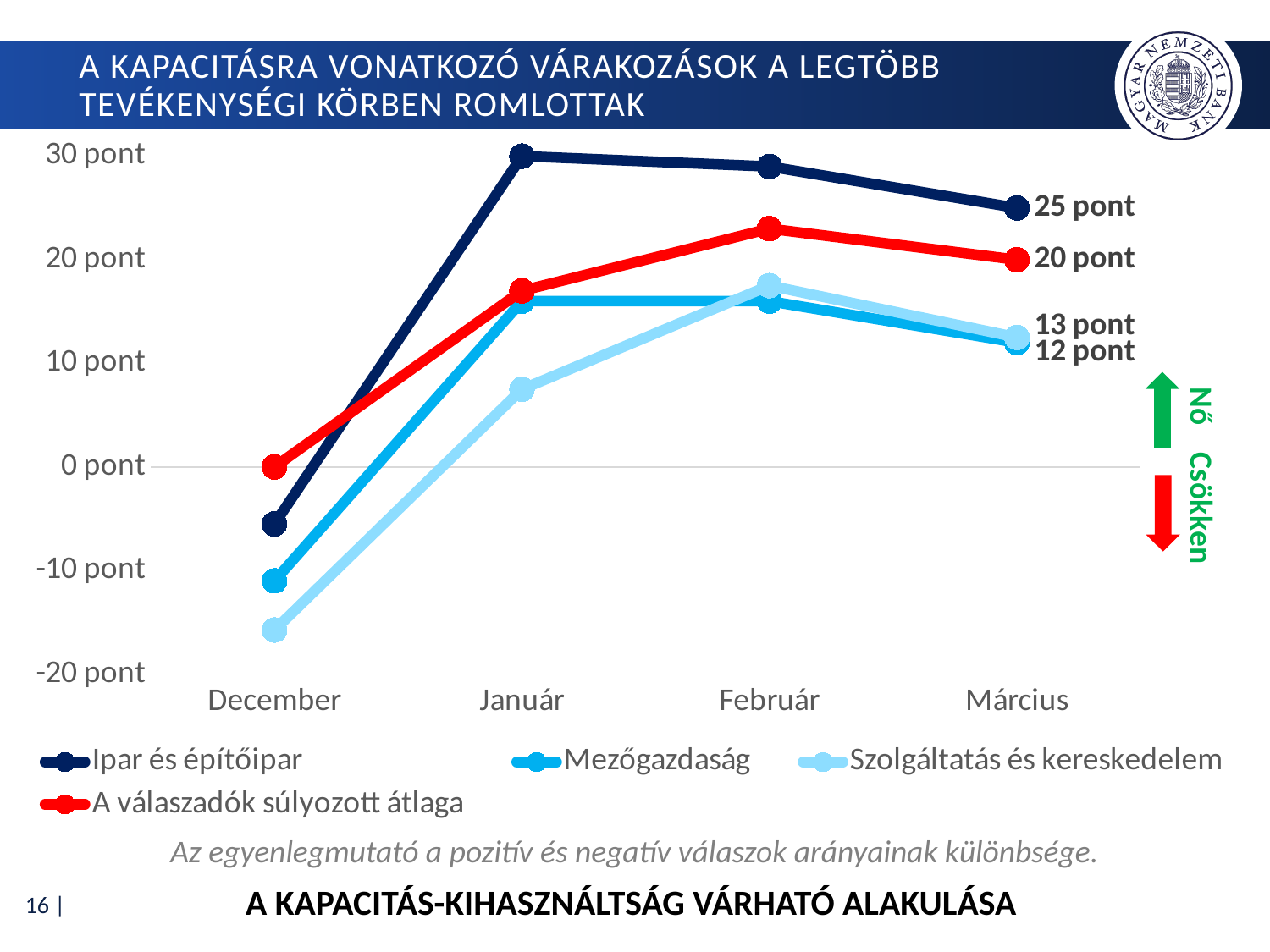
How many months are shown on the x axis? 4 What is the difference between Ipar és építőipar and A válaszadók súlyozott átlaga in Március? 5 pont What is the value for Ipar és építőipar in Március? 25 pont Does the Ipar és építőipar line rise or fall from Január to Március? fall What is the value for A válaszadók súlyozott átlaga in Március? 20 pont Is the value for Szolgáltatás és kereskedelem in Január greater or less than 10 pont? less Which series has the highest value in Március? Ipar és építőipar How many series does the legend list? 4 Which series has the lowest value in December? Szolgáltatás és kereskedelem What kind of chart is shown on the slide? line chart Is the value for Ipar és építőipar in Január greater or less than 20 pont? greater Which series is drawn in red? A válaszadók súlyozott átlaga